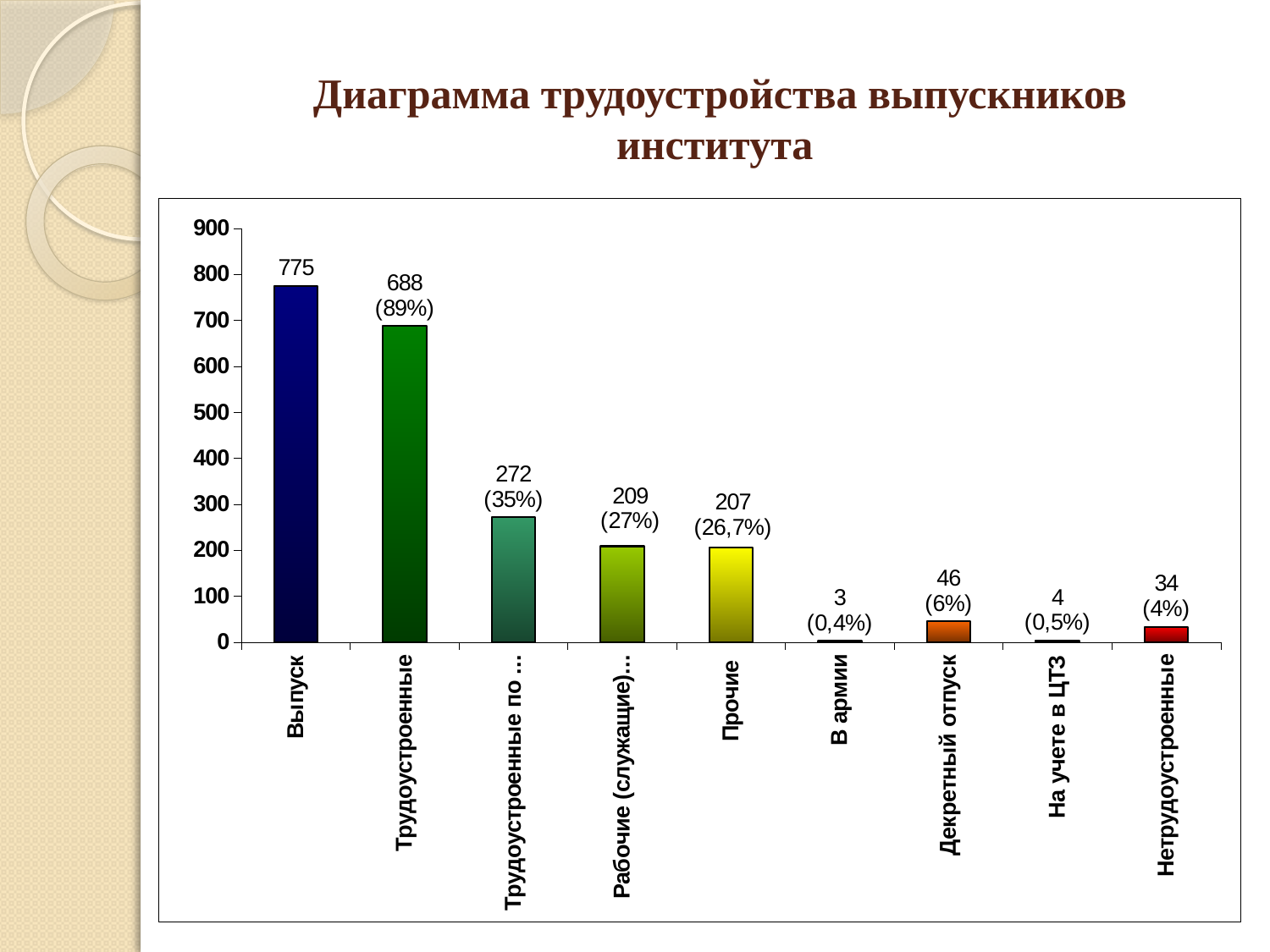
Which category has the lowest value? В армии Which is larger, the value for Декретный отпуск or the value for Нетрудоустроенные? Декретный отпуск How many categories are shown on the x axis? 9 What is the value for Выпуск? 775 What is the value for Нетрудоустроенные? 34 What is the value for Трудоустроенные? 688 What is the difference between the values for Выпуск and Трудоустроенные? 87 Which category has the highest value? Выпуск What percentage is shown for Трудоустроенные? 89% What is the value for Декретный отпуск? 46 What kind of chart is shown on the slide? bar chart What is the value for Прочие? 207